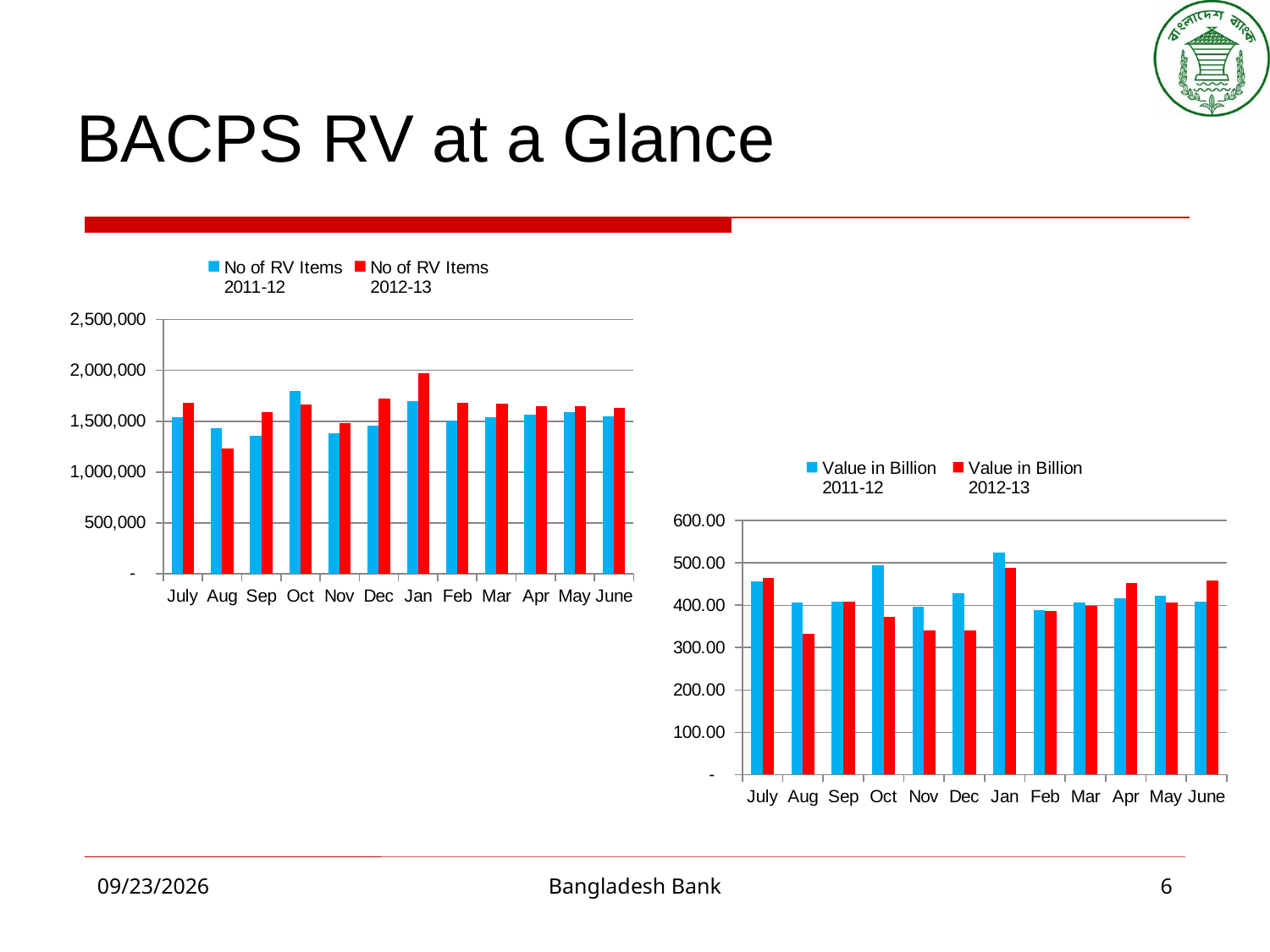
In the left chart (No of RV Items), which month has the highest value for the 2011-12 series? Oct In the left chart (No of RV Items), is the 2012-13 value for Aug greater or less than 1,500,000? less In the right chart (Value in Billion), which is larger for Oct: the 2011-12 value or the 2012-13 value? 2011-12 In the right chart (Value in Billion), which month has the lowest value for the 2012-13 series? Aug What kind of chart is the left chart (No of RV Items)? bar chart In the left chart (No of RV Items), which month has the lowest value for the 2012-13 series? Aug How many series does the legend of the right chart (Value in Billion) list? 2 In the left chart (No of RV Items), is the 2012-13 value for Jan greater or less than 1,500,000? greater In the left chart (No of RV Items), which month has the highest value for the 2012-13 series? Jan In the right chart (Value in Billion), is the 2011-12 value for Jan greater or less than 500.00? greater In the right chart (Value in Billion), which month has the highest value for the 2011-12 series? Jan How many months are shown on the x axis of the left chart (No of RV Items)? 12